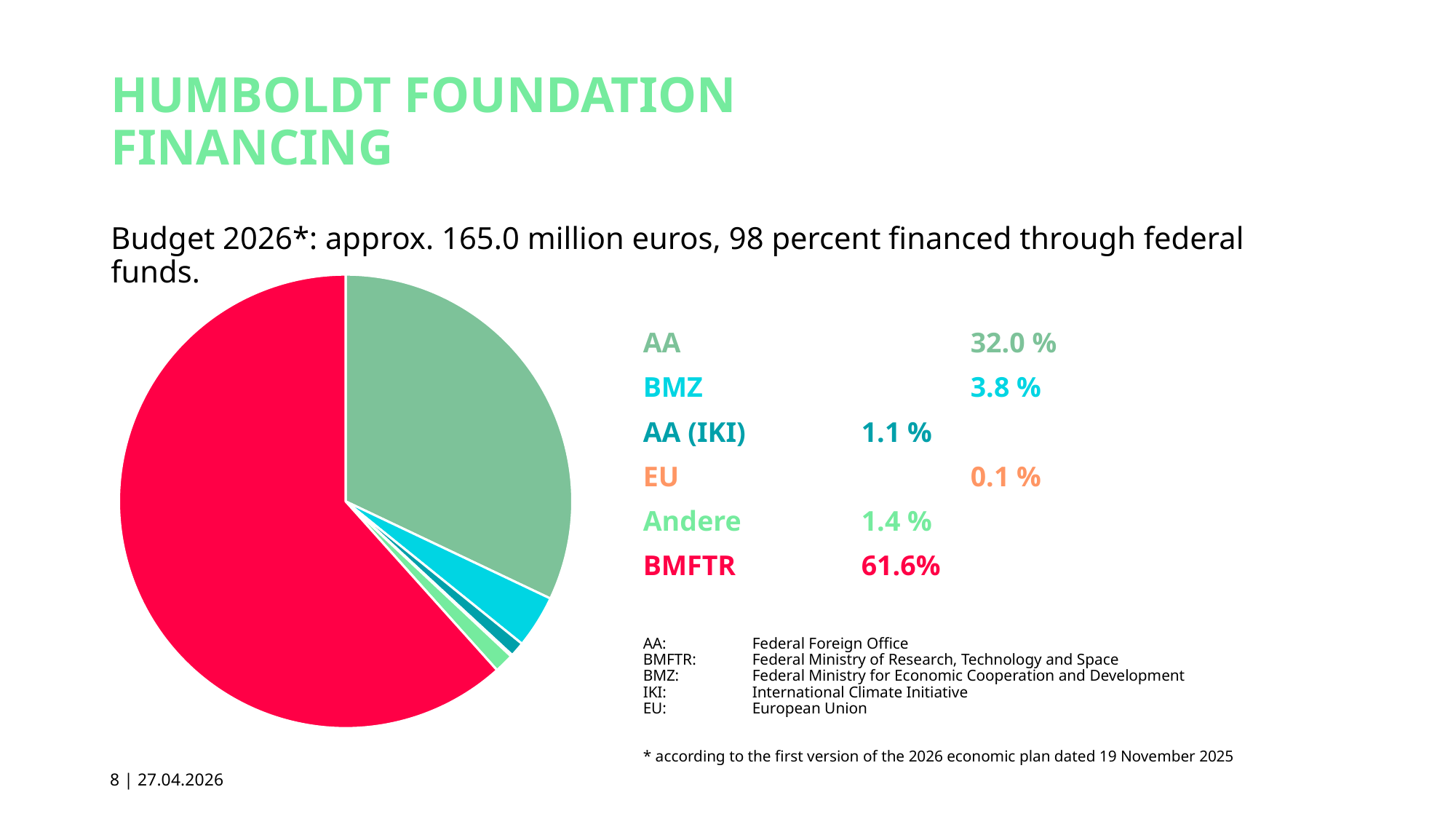
What is the difference in percentage points between the BMFTR share and the AA share? 29.6 Which funding source has the largest share of the budget? BMFTR What share of the budget comes from AA? 32.0 % What kind of chart is shown on the slide? pie chart How many slices does the pie chart have? 6 What share of the budget comes from BMZ? 3.8 % Which funding source has the smallest share of the budget? EU According to the legend, what does BMFTR stand for? Federal Ministry of Research, Technology and Space Which is larger, the share for BMZ or the share for Andere? BMZ What share of the budget comes from BMFTR? 61.6% What share of the budget comes from the EU? 0.1 % What share of the budget comes from Andere? 1.4 %